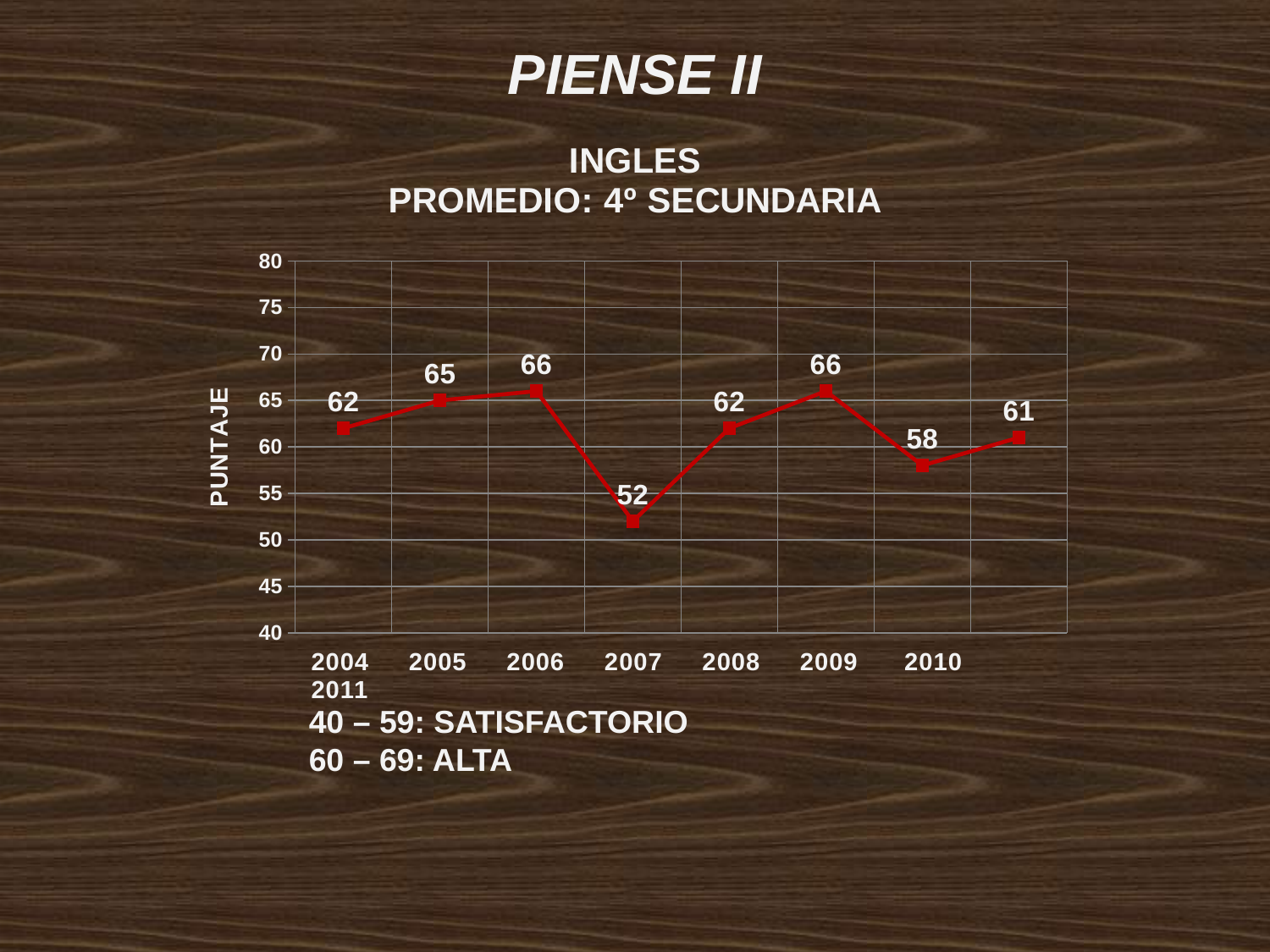
Which year has the lowest PUNTAJE value? 2007 What is the PUNTAJE value for 2004? 62 Which year has a larger PUNTAJE value, 2005 or 2010? 2005 What is the PUNTAJE value for 2011? 61 Is the PUNTAJE value for 2009 greater or less than 60? greater What is the PUNTAJE value for 2010? 58 How many years are plotted on the chart? 8 Does the PUNTAJE value rise or fall from 2009 to 2010? fall What type of chart is shown on the slide? line chart What is the PUNTAJE value for 2007? 52 What is the highest PUNTAJE value plotted on the chart? 66 What is the difference between the PUNTAJE values for 2006 and 2007? 14